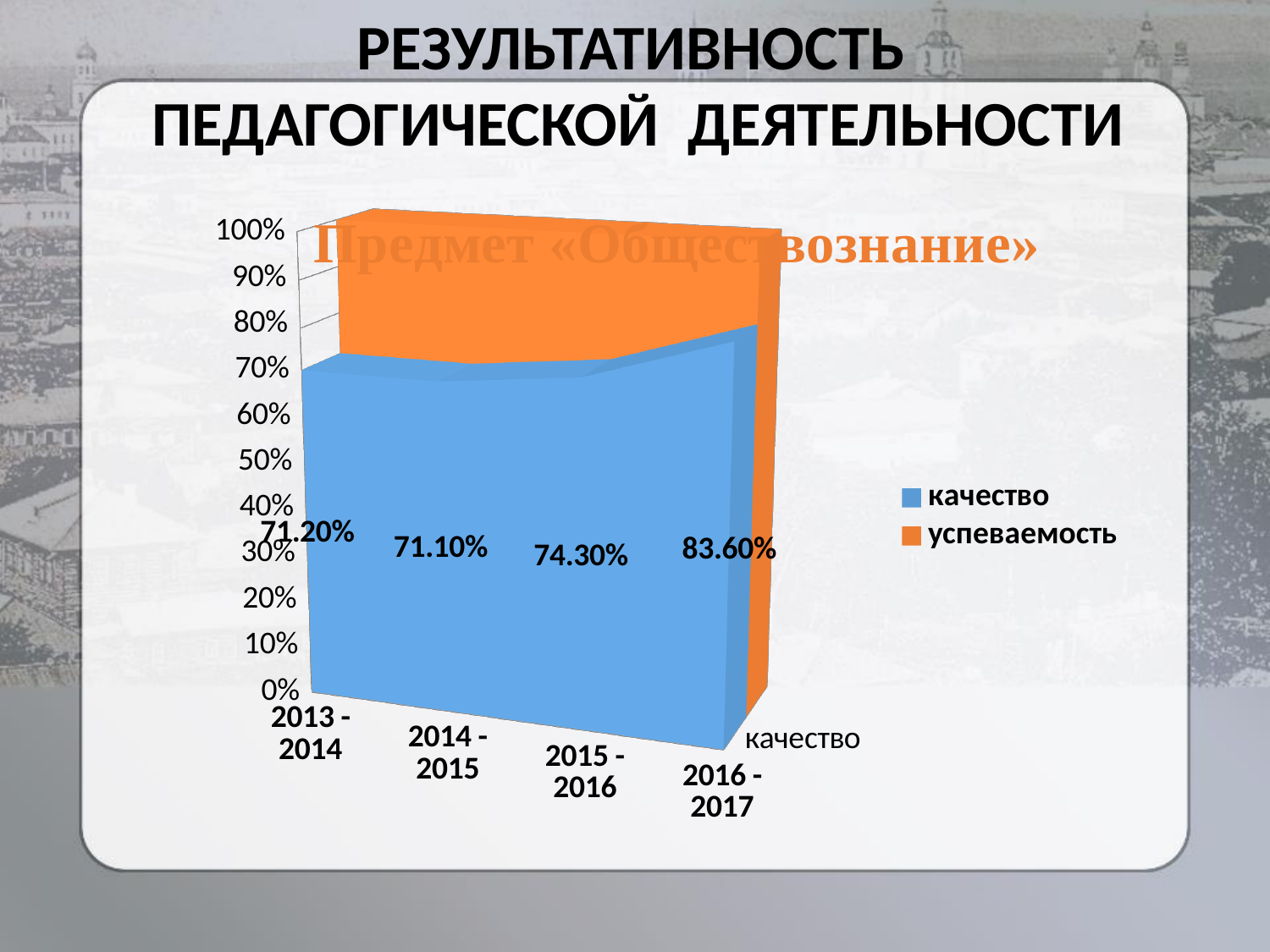
What is the value of качество for 2013 - 2014? 71.20% What is the difference between качество in 2015 - 2016 and in 2014 - 2015? 3.20% Is the value of успеваемость for 2013 - 2014 greater or less than 90%? greater How many school years are shown on the x axis? 4 In which school year is качество the highest? 2016 - 2017 Which year has the larger качество value: 2015 - 2016 or 2014 - 2015? 2015 - 2016 What is the value of качество for 2016 - 2017? 83.60% In which school year is качество the lowest? 2014 - 2015 By how much does качество in 2016 - 2017 exceed качество in 2013 - 2014? 12.40% What is the value of качество for 2015 - 2016? 74.30% How many series does the legend list? 2 What is the title of the chart? Предмет «Обществознание»